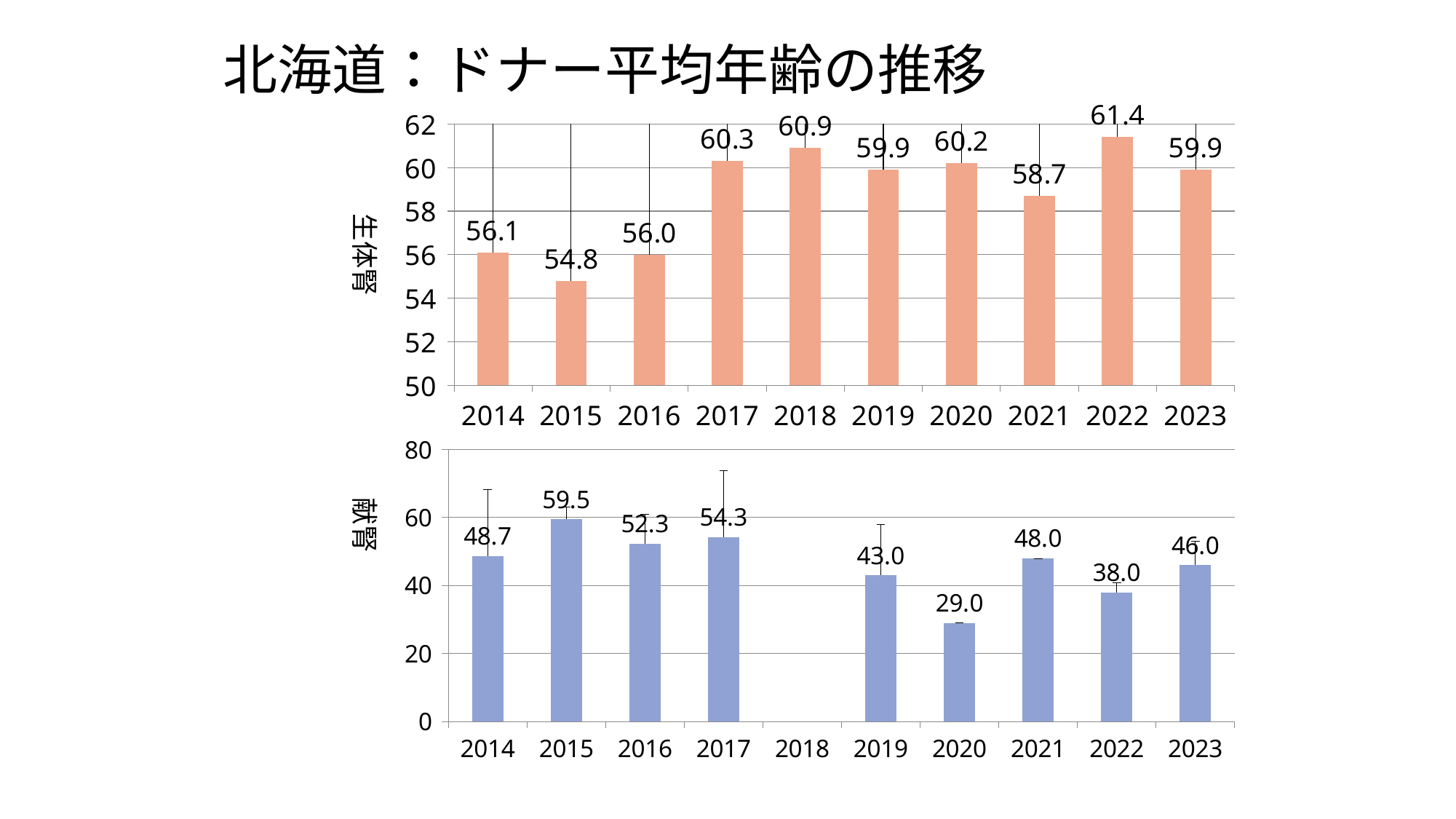
In the top chart (生体腎), what is the value for 2022? 61.4 In the bottom chart (献腎), what is the difference between the 2015 value and the 2020 value? 30.5 In the bottom chart (献腎), which year has the lowest value? 2020 What is the title of the slide? 北海道：ドナー平均年齢の推移 In the top chart (生体腎), what is the difference between the 2022 value and the 2015 value? 6.6 In the bottom chart (献腎), which year has no bar plotted? 2018 What type of chart is the top chart (生体腎)? Bar chart In the top chart (生体腎), which is larger, the value for 2018 or the value for 2021? 2018 In the top chart (生体腎), which year has the lowest value? 2015 In the top chart (生体腎), which year has the highest value? 2022 In the bottom chart (献腎), what is the value for 2020? 29.0 In the bottom chart (献腎), which year has the highest value? 2015